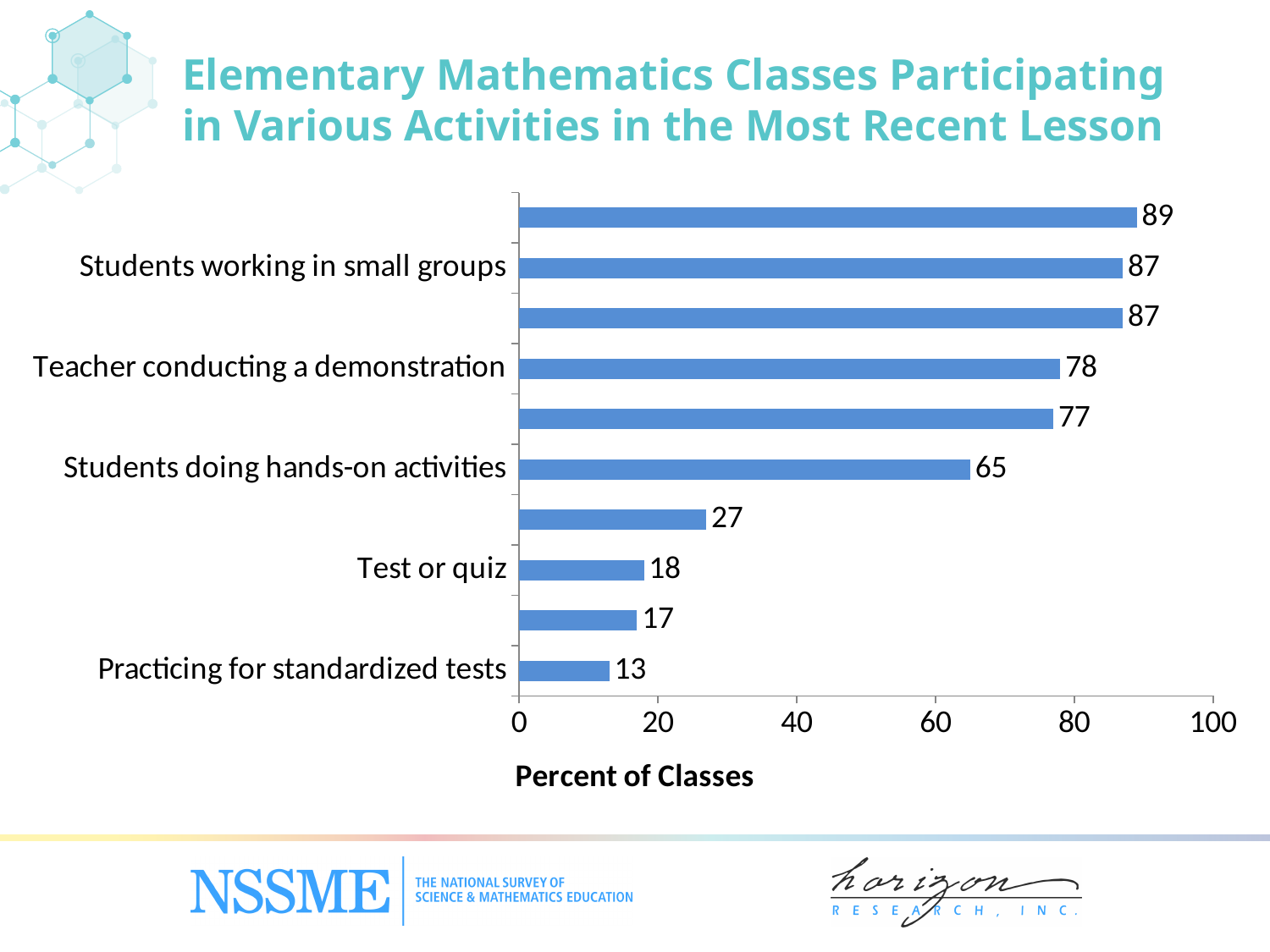
What percent of classes had the teacher conducting a demonstration? 78 How many bars are plotted on the chart? 10 What is the highest value shown on the chart? 89 What is the difference in percent of classes between students working in small groups and students doing hands-on activities? 22 What percent of classes were practicing for standardized tests? 13 Which labeled activity has the lowest percent of classes? Practicing for standardized tests What percent of classes had students doing hands-on activities? 65 What percent of classes had a test or quiz? 18 What is the label of the horizontal axis? Percent of Classes What kind of chart is shown on the slide? Bar chart What percent of classes had students working in small groups? 87 Which has a higher percent of classes: teacher conducting a demonstration or test or quiz? Teacher conducting a demonstration